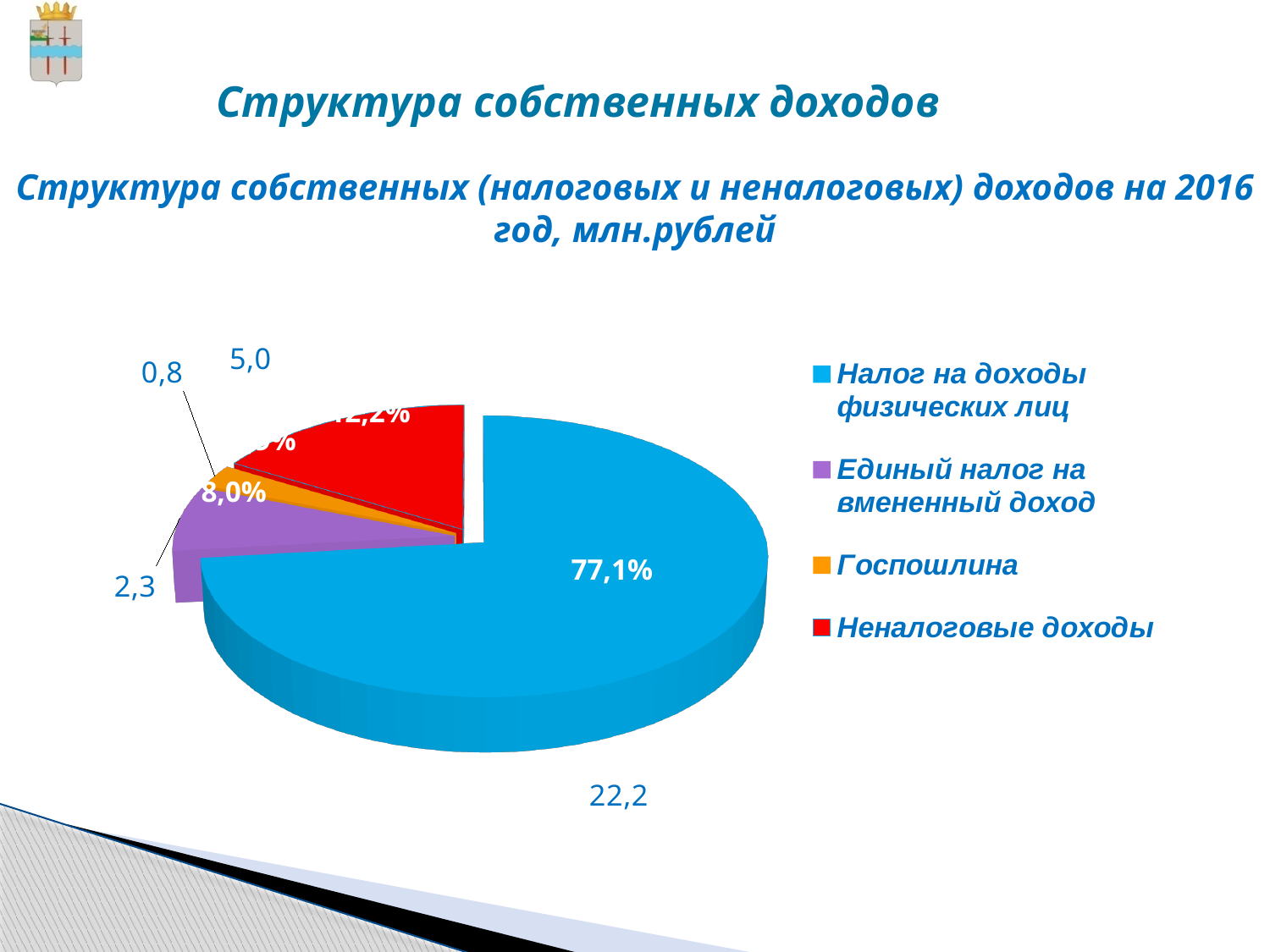
How many slices does the pie chart have? 4 What is the value (млн.рублей) for Налог на доходы физических лиц? 22,2 Which category has the smallest slice of the pie? Госпошлина What is the value (млн.рублей) for Неналоговые доходы? 5,0 What share of the pie does Единый налог на вмененный доход represent? 8,0% What is the value (млн.рублей) for Единый налог на вмененный доход? 2,3 What kind of chart is shown on the slide? pie chart How many entries does the legend list? 4 Which category has the largest slice of the pie? Налог на доходы физических лиц What is the value (млн.рублей) for Госпошлина? 0,8 What is the difference between the values for Налог на доходы физических лиц and Неналоговые доходы? 17,2 What share of the pie does Налог на доходы физических лиц represent? 77,1%